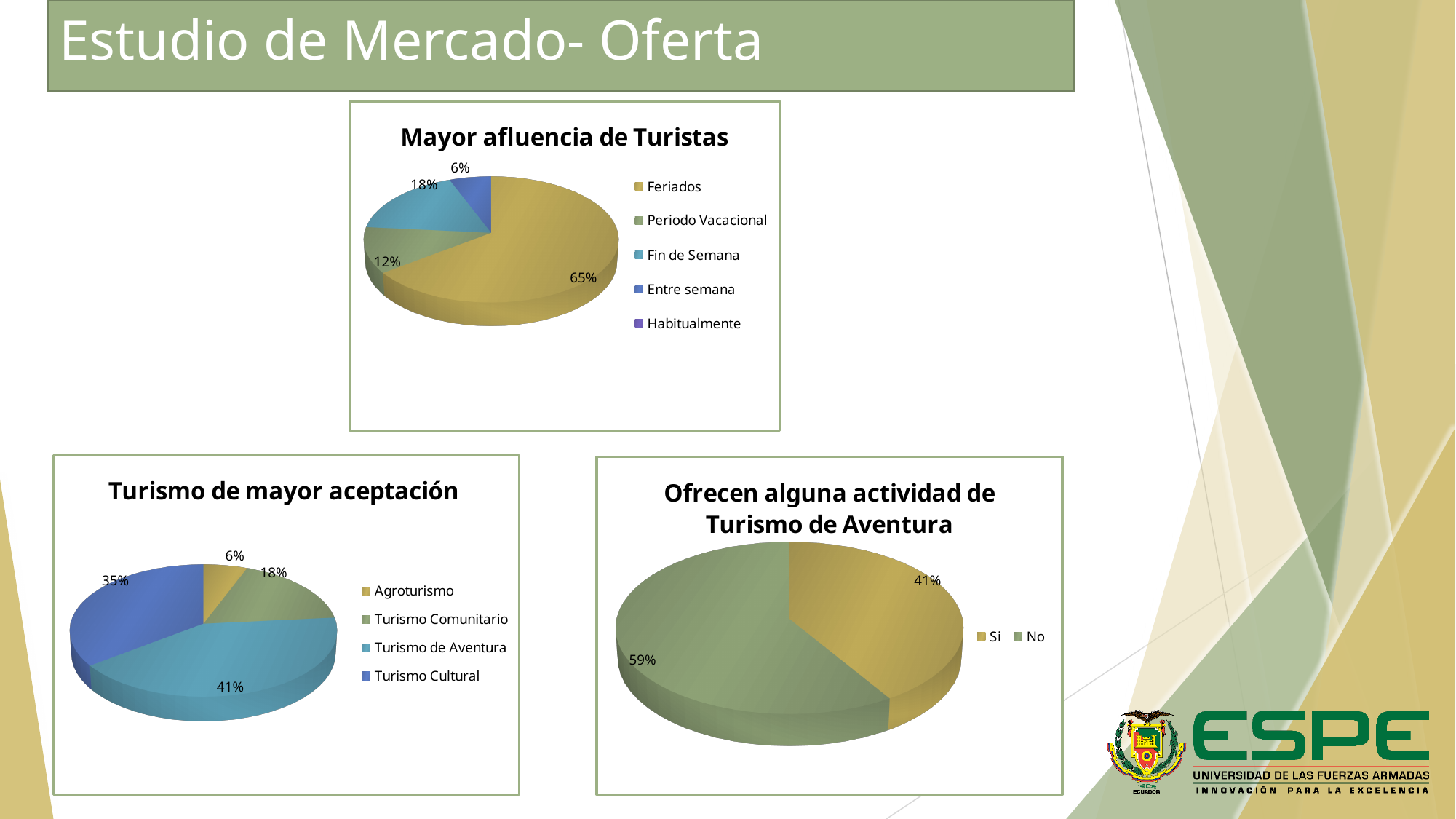
What type of chart is the chart titled "Ofrecen alguna actividad de Turismo de Aventura"? Pie chart In the chart titled "Mayor afluencia de Turistas", which is larger: Periodo Vacacional or Fin de Semana? Fin de Semana In the chart titled "Turismo de mayor aceptación", what is the difference in percentage points between Turismo de Aventura and Turismo Cultural? 6 percentage points How many entries does the legend of the chart titled "Mayor afluencia de Turistas" list? 5 In the chart titled "Mayor afluencia de Turistas", what percentage is shown for Feriados? 65% In the chart titled "Mayor afluencia de Turistas", what percentage is shown for Fin de Semana? 18% In the chart titled "Ofrecen alguna actividad de Turismo de Aventura", what percentage answered No? 59% How many categories are shown in the chart titled "Turismo de mayor aceptación"? 4 In the chart titled "Turismo de mayor aceptación", which category has the smallest share? Agroturismo In the chart titled "Ofrecen alguna actividad de Turismo de Aventura", what is the difference in percentage points between No and Si? 18 percentage points In the chart titled "Mayor afluencia de Turistas", which category has the largest share? Feriados In the chart titled "Turismo de mayor aceptación", what percentage is shown for Turismo de Aventura? 41%